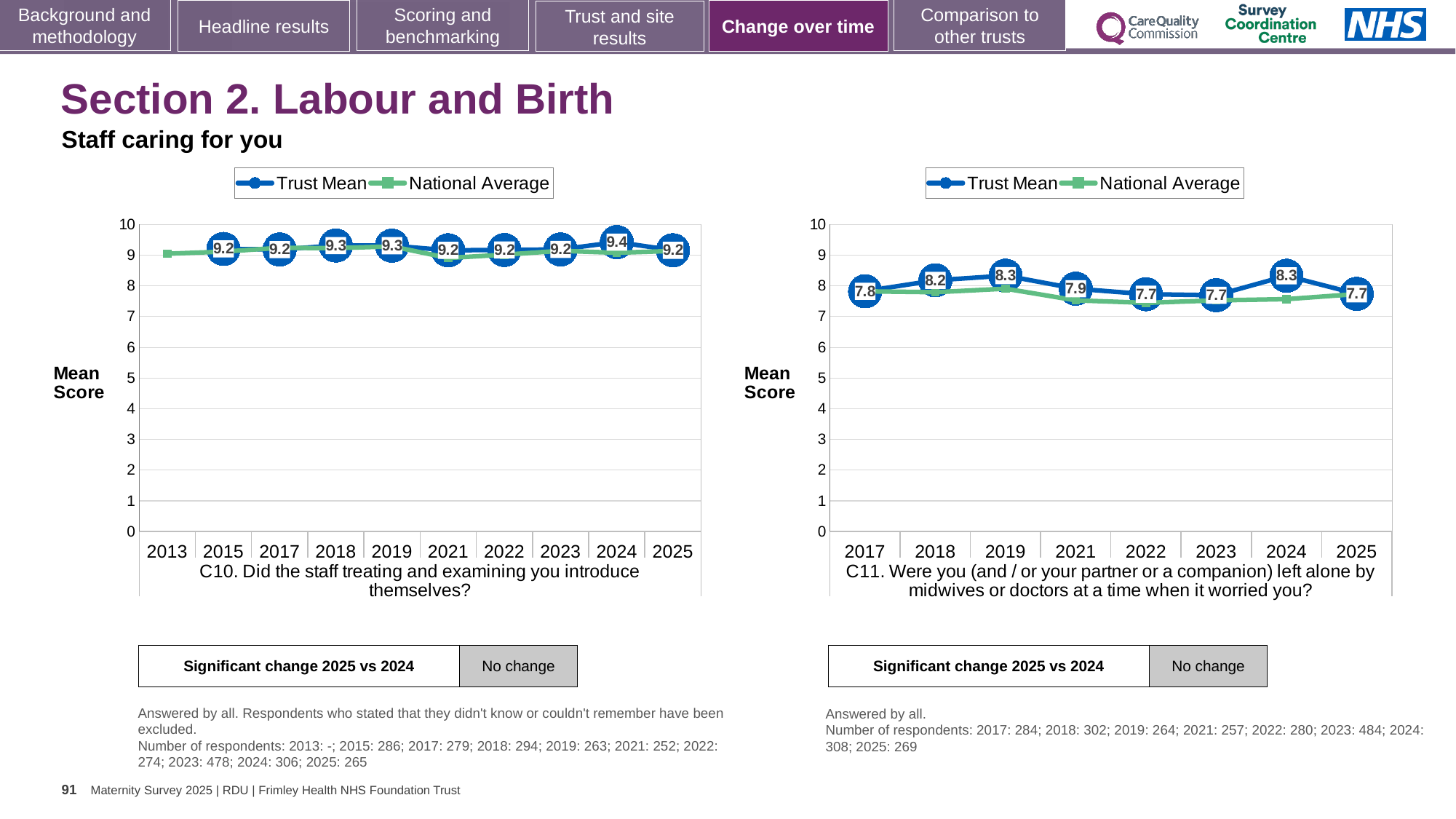
On the left chart (C10), what is the Trust Mean value for 2024? 9.4 On the right chart (C11), what is the Trust Mean value for 2018? 8.2 How many years are shown on the x axis of the right chart (C11)? 8 On the left chart (C10), which year has the highest Trust Mean value? 2024 On the right chart (C11), is the National Average value for 2025 greater or less than 8? less How many years are shown on the x axis of the left chart (C10)? 10 On the right chart (C11), which is larger, the Trust Mean for 2018 or for 2022? 2018 On the left chart (C10), what is the difference between the Trust Mean values for 2024 and 2025? 0.2 On the right chart (C11), what is the difference between the Trust Mean values for 2019 and 2025? 0.6 How many series does the legend of the right chart (C11) list? 2 What kind of chart is the left chart (C10)? Line chart On the right chart (C11), does the Trust Mean rise or fall from 2024 to 2025? Fall